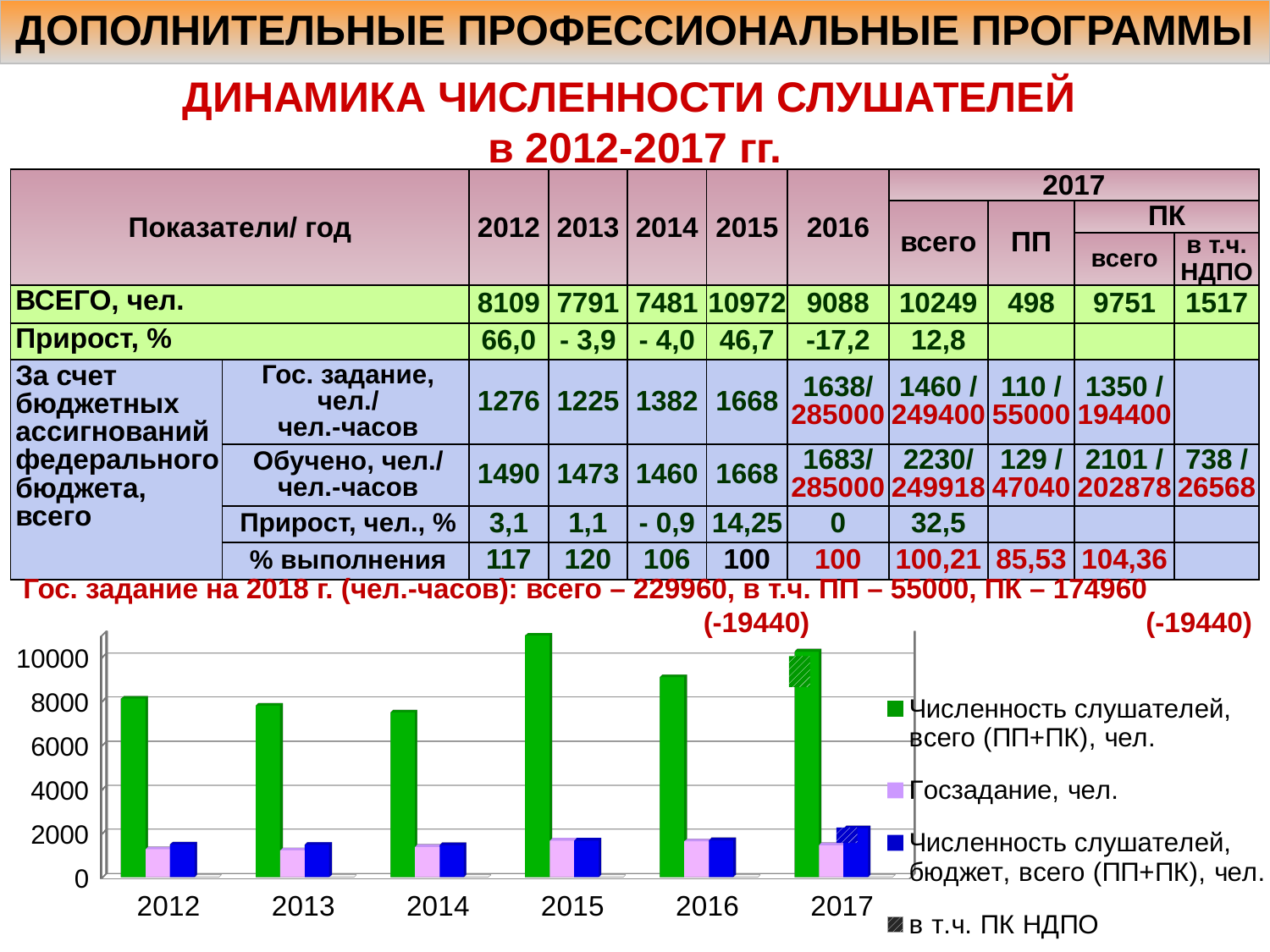
How many series does the chart legend list? 4 Is the blue bar (Численность слушателей, бюджет, всего (ПП+ПК), чел.) for 2017 greater or less than 2000? greater Is the green bar for 2014 greater or less than 8000? less In which year is the green bar (Численность слушателей, всего (ПП+ПК), чел.) lowest? 2014 How many years are shown on the x axis of the chart? 6 What kind of chart is shown at the bottom of the slide? bar chart In which year is the green bar (Численность слушателей, всего (ПП+ПК), чел.) highest? 2015 Is the green bar for 2015 greater or less than 10000? greater Which year has the larger green bar, 2016 or 2017? 2017 Which colour represents Госзадание, чел. in the chart legend? pink Do the green bars rise or fall from 2012 to 2014? fall